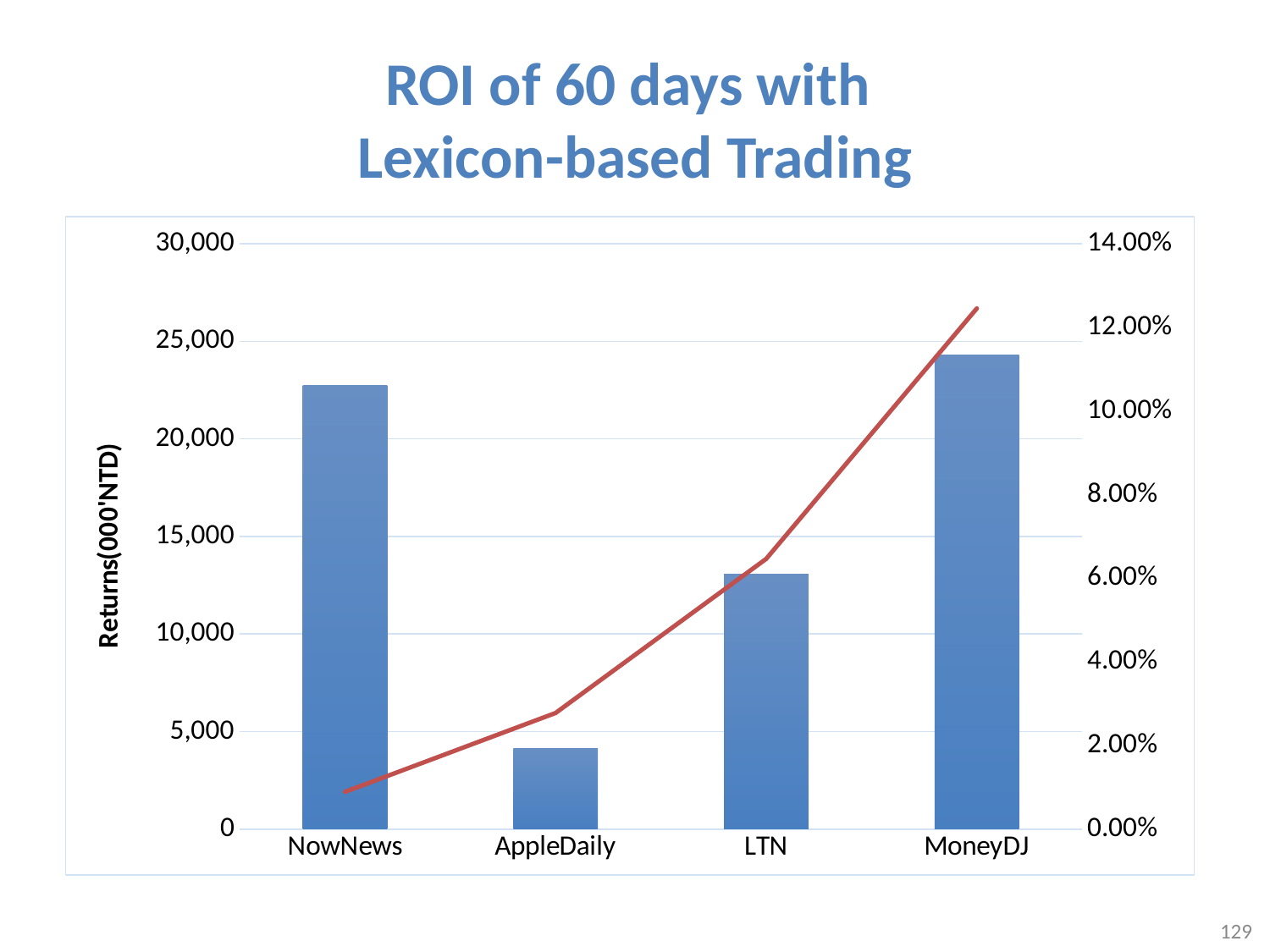
Is the bar value for MoneyDJ greater or less than 25,000? less Which category has the shortest bar? AppleDaily Is the bar value for NowNews greater or less than 20,000? greater What kind of chart is shown on the slide? A bar chart combined with a line Which has the larger bar, LTN or AppleDaily? LTN How many categories are shown on the x axis? 4 Does the red line rise or fall from NowNews to MoneyDJ? rises What is the label on the left vertical axis? Returns(000'NTD) Which category has the tallest bar? MoneyDJ Is the bar value for LTN greater or less than 10,000? greater What is the title of the chart? ROI of 60 days with Lexicon-based Trading